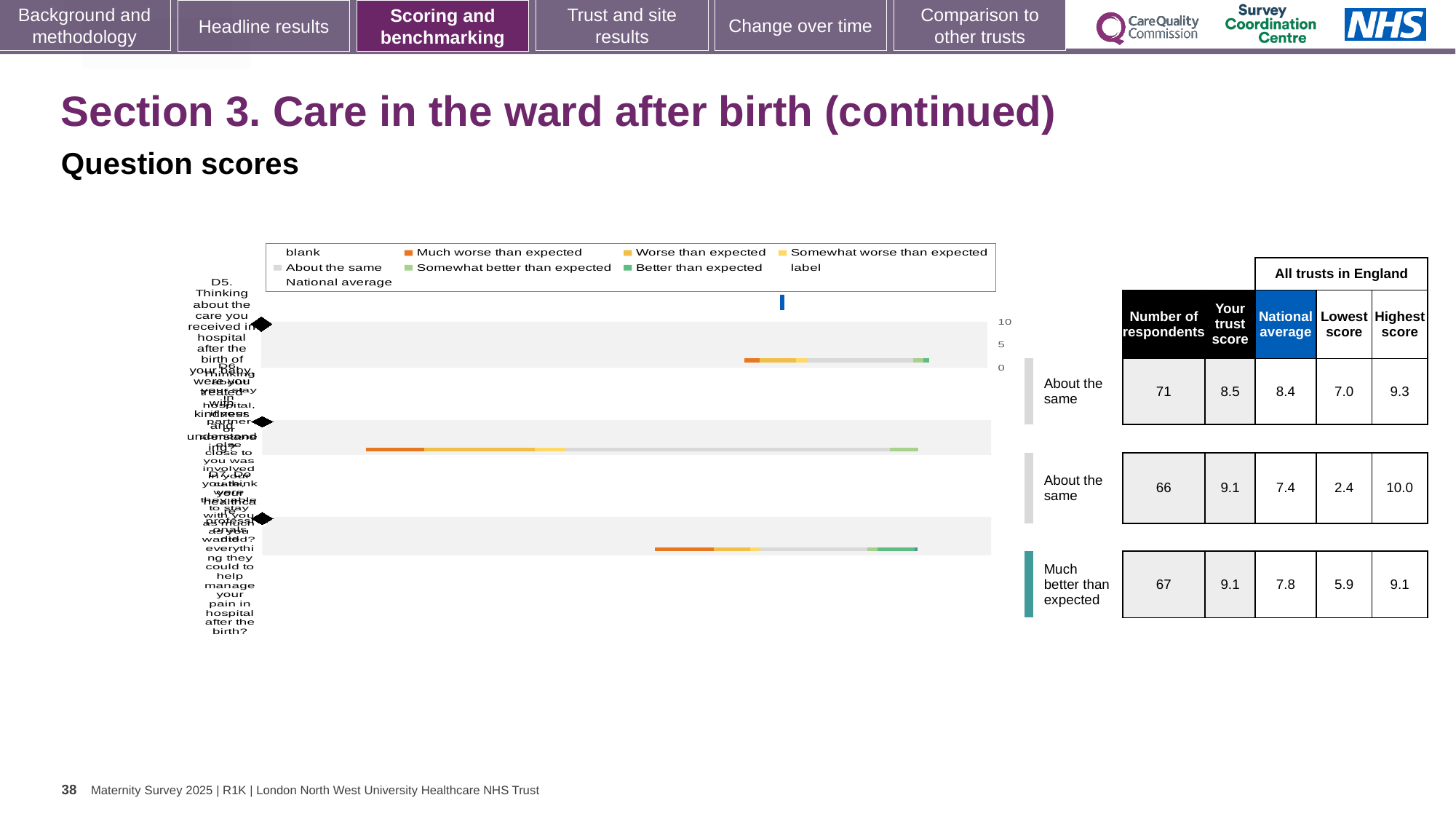
In the table to the right of the chart, is the trust score for the row labelled 'Much better than expected' larger or smaller than its national average? larger In the table to the right of the chart, which row has the highest 'Highest score' value? the second row (10.0) What is the highest value shown on the chart's score axis? 10 What kind of chart is shown on the slide? bar chart What colour does the legend use for 'Much worse than expected'? orange How many entries does the chart legend list? 9 How many question rows (bars) are plotted in the chart? 3 What colour does the legend use for 'Better than expected'? green In the table to the right of the chart, what is the number of respondents for the second row? 66 In the table to the right of the chart, what is the difference between the trust score and the national average for the second row? 1.7 In the table to the right of the chart, what is the 'Your trust score' for the first row? 8.5 In the table to the right of the chart, what is the national average for the row labelled 'Much better than expected'? 7.8